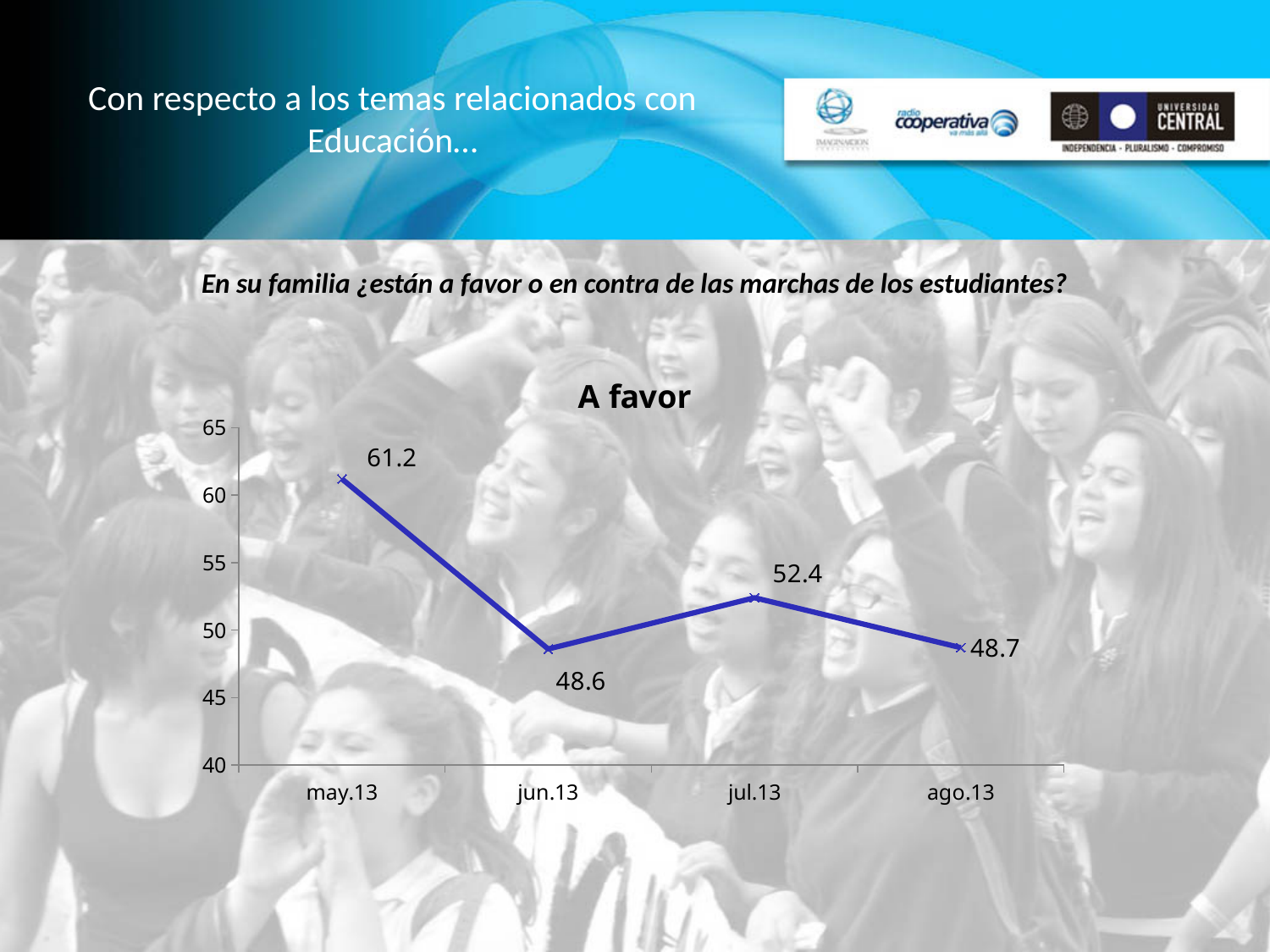
What is the value for jun.13? 48.6 What is the value for ago.13? 48.7 What is the difference between the values for jul.13 and ago.13? 3.7 What is the value for jul.13? 52.4 Is the value for may.13 greater or less than 60? greater What is the value for may.13? 61.2 What is the difference between the values for may.13 and jun.13? 12.6 What is the title of the chart? A favor What kind of chart is shown? line chart How many data points are plotted on the chart? 4 Which month has the highest value? may.13 Which is larger, the value for jul.13 or the value for jun.13? jul.13